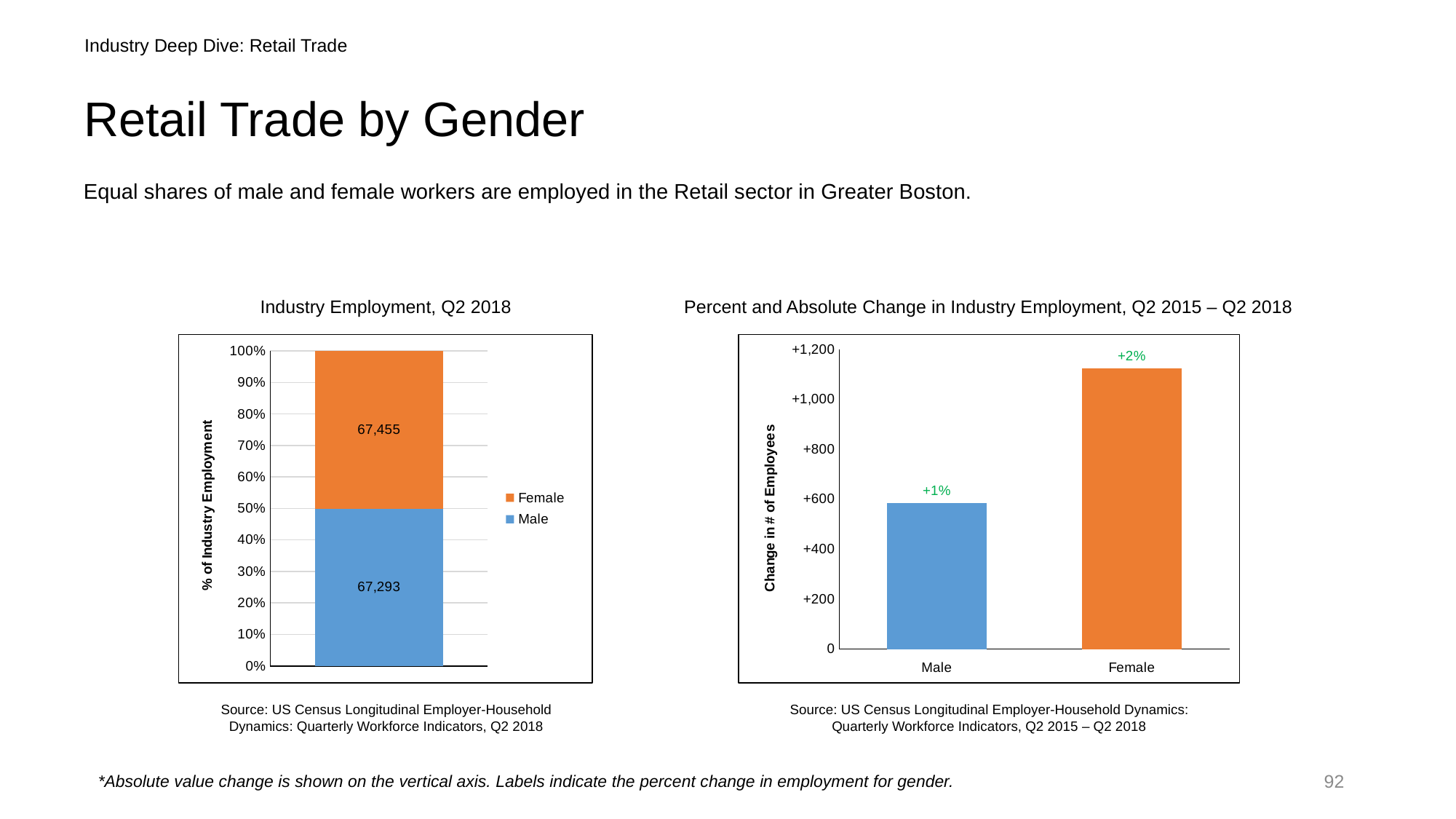
In the 'Percent and Absolute Change in Industry Employment, Q2 2015 – Q2 2018' chart, which category has the highest bar? Female In the 'Industry Employment, Q2 2018' chart, what is the total of the Female and Male values in the stacked bar? 134,748 In the 'Percent and Absolute Change in Industry Employment, Q2 2015 – Q2 2018' chart, is the value for Male greater or less than +800? less In the 'Industry Employment, Q2 2018' chart, what is the difference between the Female and Male values? 162 In the 'Percent and Absolute Change in Industry Employment, Q2 2015 – Q2 2018' chart, is the value for Female greater or less than +1,000? greater In the 'Industry Employment, Q2 2018' chart, what is the value shown for Male? 67,293 In the 'Percent and Absolute Change in Industry Employment, Q2 2015 – Q2 2018' chart, what percent change label is shown above the Female bar? +2% In the 'Industry Employment, Q2 2018' chart, what is the value shown for Female? 67,455 What kind of chart is the 'Percent and Absolute Change in Industry Employment, Q2 2015 – Q2 2018' chart? bar chart In the 'Percent and Absolute Change in Industry Employment, Q2 2015 – Q2 2018' chart, what percent change label is shown above the Male bar? +1% In the 'Industry Employment, Q2 2018' chart, how many series does the legend list? 2 In the 'Industry Employment, Q2 2018' chart, what is the label of the vertical axis? % of Industry Employment